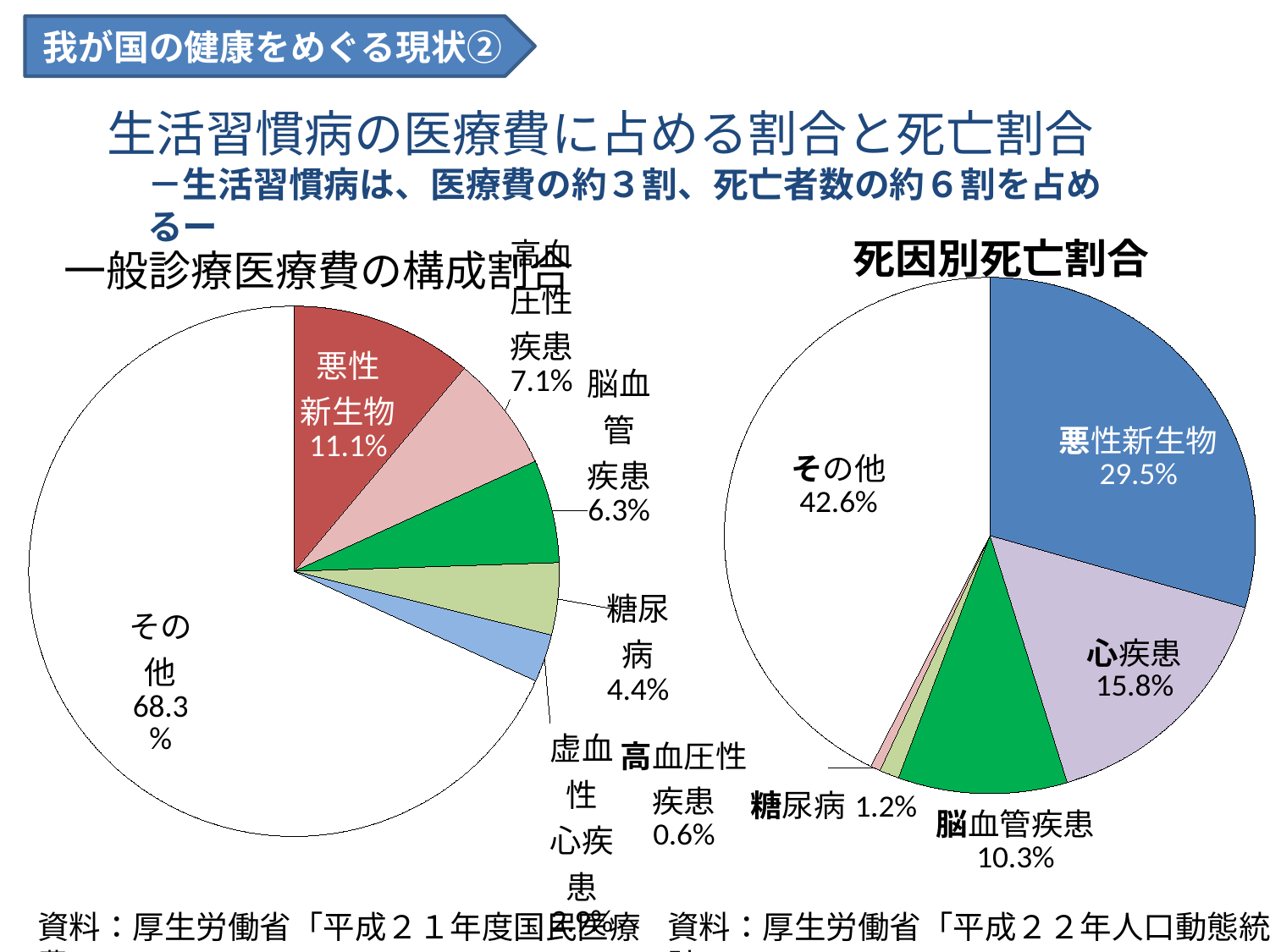
In the 一般診療医療費の構成割合 pie chart, which is larger, 高血圧性疾患 or 脳血管疾患? 高血圧性疾患 In the 一般診療医療費の構成割合 pie chart, what share is 悪性新生物? 11.1% In the 一般診療医療費の構成割合 pie chart, what share is その他? 68.3% In the 死因別死亡割合 pie chart, what share is 悪性新生物? 29.5% What kind of chart is 死因別死亡割合? Pie chart In the 死因別死亡割合 pie chart, what share is 高血圧性疾患? 0.6% In the 死因別死亡割合 pie chart, what share is 心疾患? 15.8% In the 一般診療医療費の構成割合 pie chart, what share is 糖尿病? 4.4% How many slices does the 死因別死亡割合 pie chart have? 6 In the 死因別死亡割合 pie chart, what is the difference between 悪性新生物 and 心疾患? 13.7% In the 死因別死亡割合 pie chart, which category has the largest share? その他 In the 死因別死亡割合 pie chart, which category has the smallest share? 高血圧性疾患